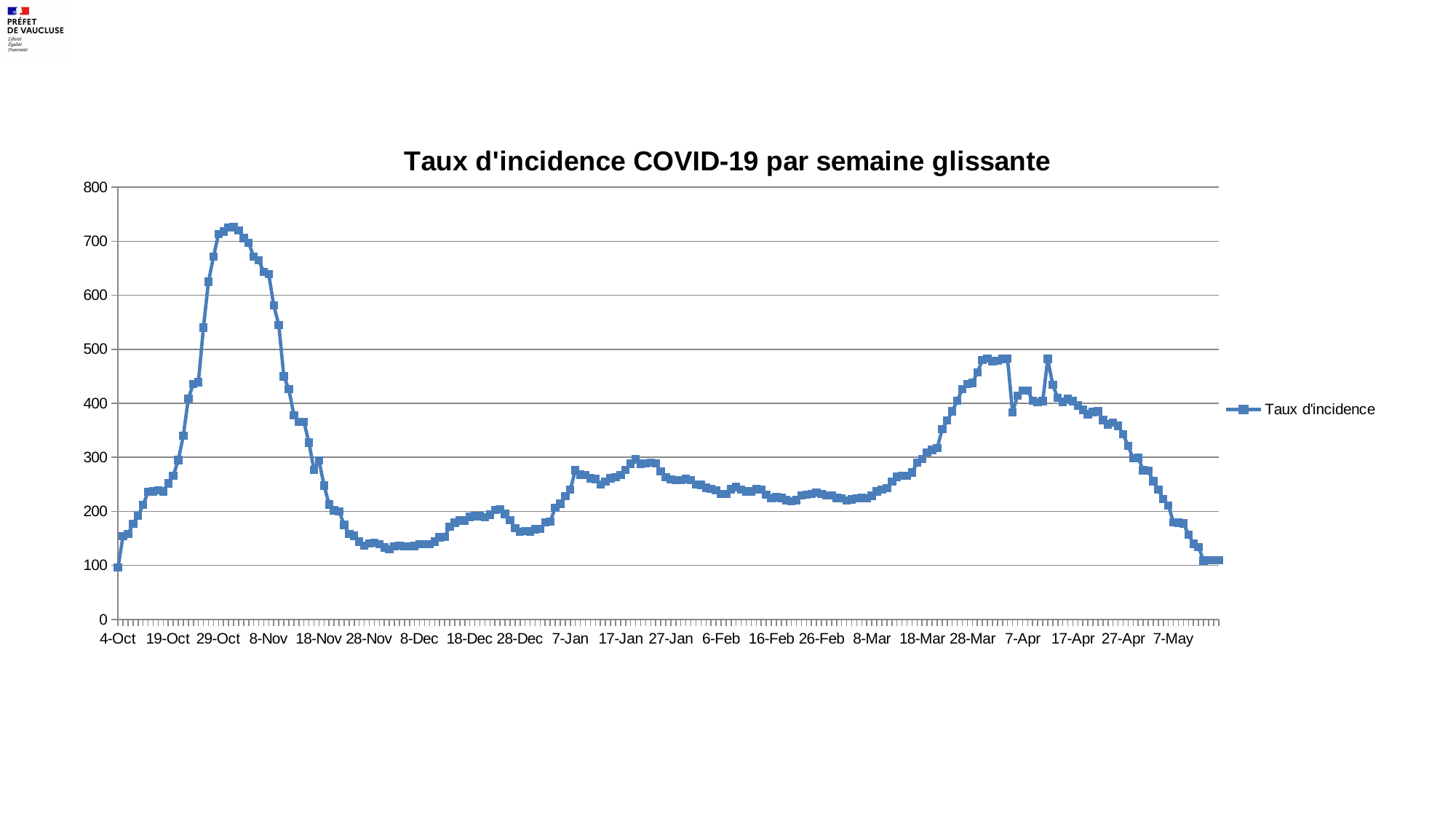
Is the value for 27-Apr greater or less than 400? less What is the name of the series shown in the legend? Taux d'incidence Is the value for 29-Oct greater or less than 600? greater How many series does the legend list? 1 Do the values rise or fall between 4-Oct and 29-Oct? rise What is the title of the chart? Taux d'incidence COVID-19 par semaine glissante Is the highest value on the chart greater or less than 700? greater What kind of chart is shown on the slide? line chart Do the values rise or fall between 28-Mar and 7-May? fall Which is larger, the value for 29-Oct or the value for 28-Mar? 29-Oct